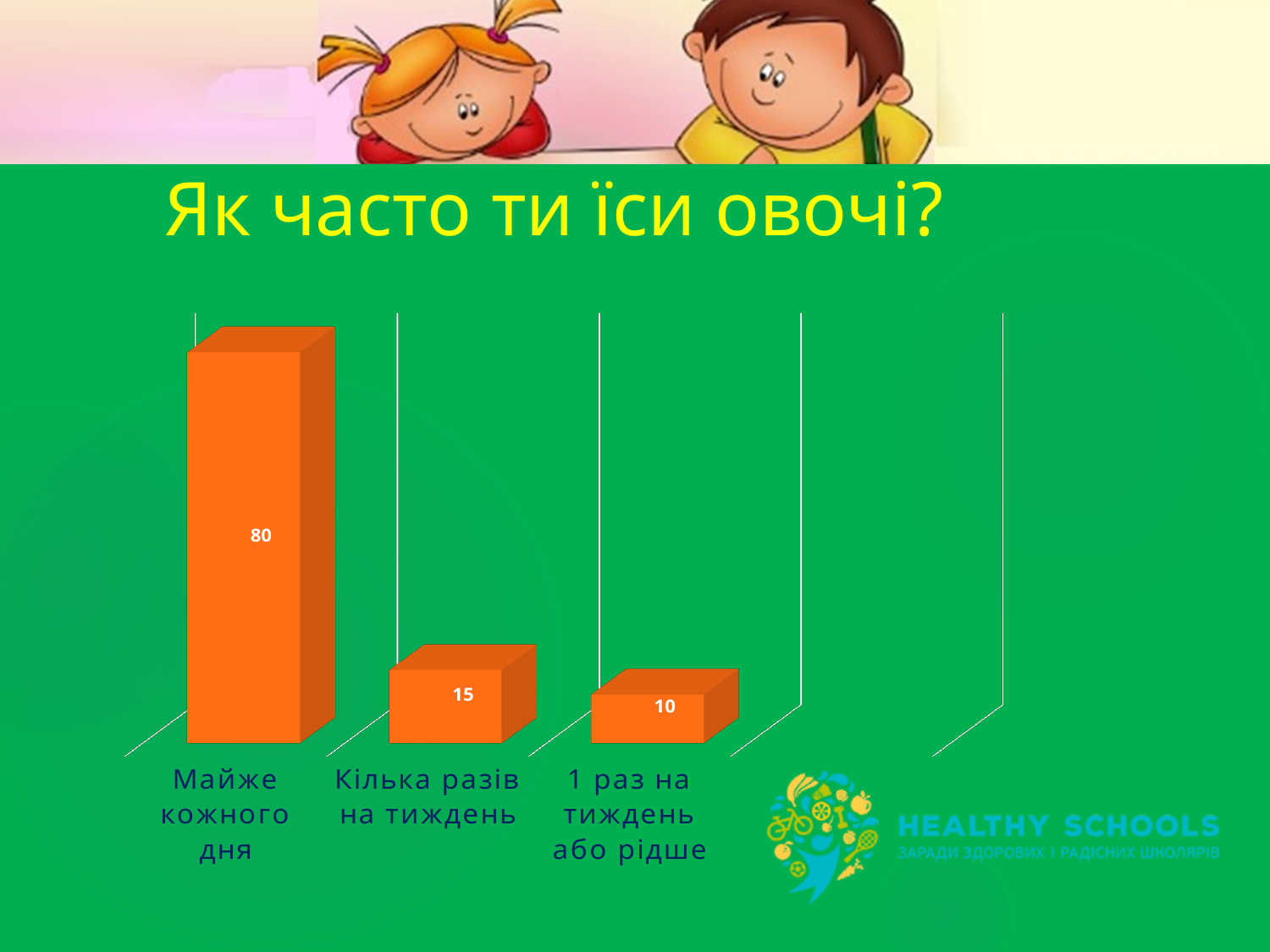
What kind of chart is shown on the slide? Bar chart How many categories are shown in the chart? 3 Which is larger, the value for "Кілька разів на тиждень" or the value for "1 раз на тиждень або рідше"? Кілька разів на тиждень What is the value for "Кілька разів на тиждень"? 15 What is the value for "Майже кожного дня"? 80 Which category has the lowest value? 1 раз на тиждень або рідше What is the value for "1 раз на тиждень або рідше"? 10 Which category has the highest value? Майже кожного дня Do the values rise or fall from left to right across the categories? Fall What is the difference between the values for "Кілька разів на тиждень" and "1 раз на тиждень або рідше"? 5 What is the difference between the values for "Майже кожного дня" and "Кілька разів на тиждень"? 65 What is the title of the chart on the slide? Як часто ти їси овочі?